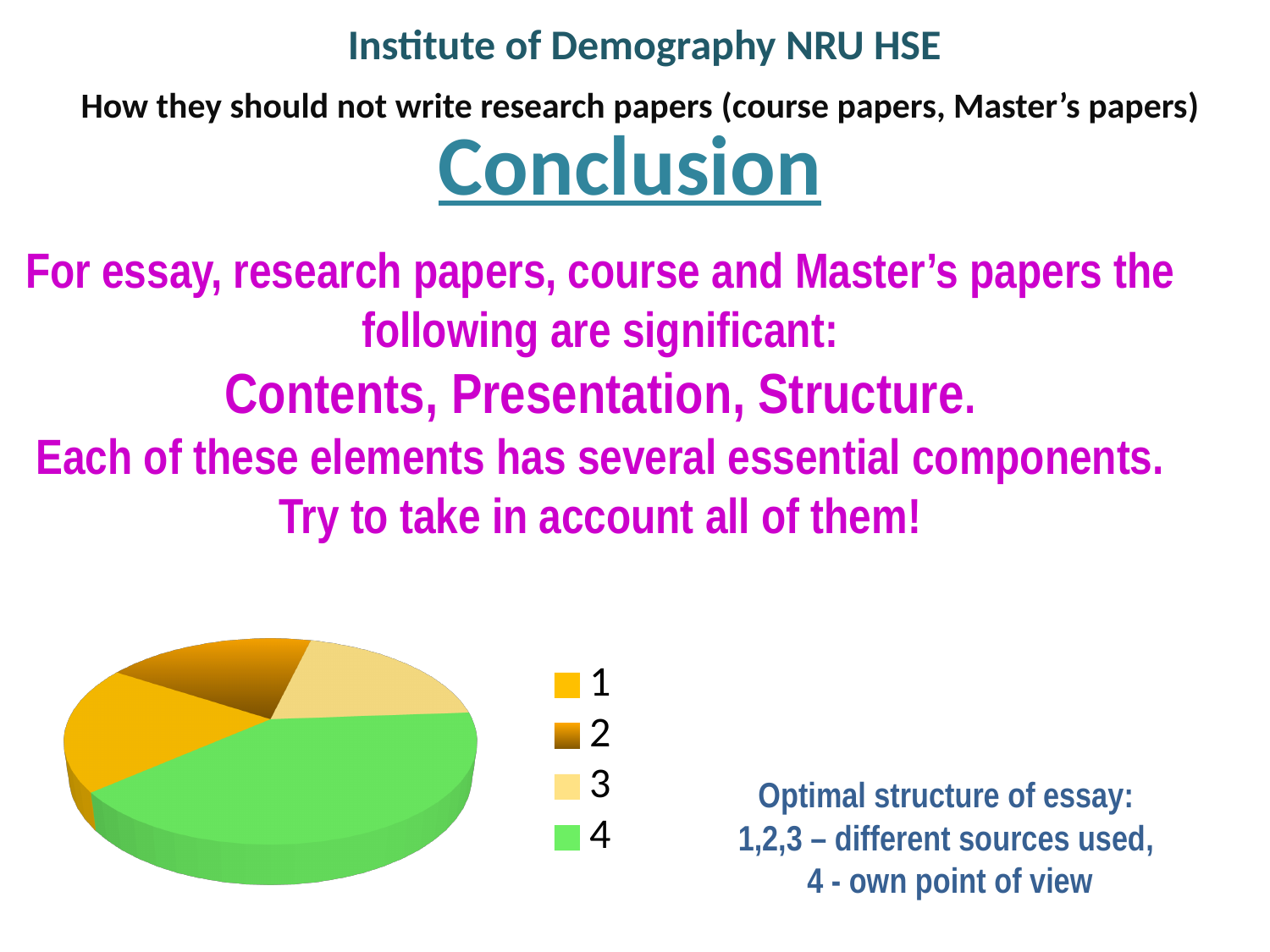
Which slice of the pie chart is the largest? 4 What kind of chart is shown on the slide? pie chart According to the caption next to the pie chart, what does slice 4 represent? own point of view How many slices does the pie chart have? 4 Which slice is larger in the pie chart, slice 4 or slice 1? 4 Which slice is larger in the pie chart, slice 2 or slice 4? 4 What colour is slice 4 in the pie chart? green How many entries does the legend of the pie chart list? 4